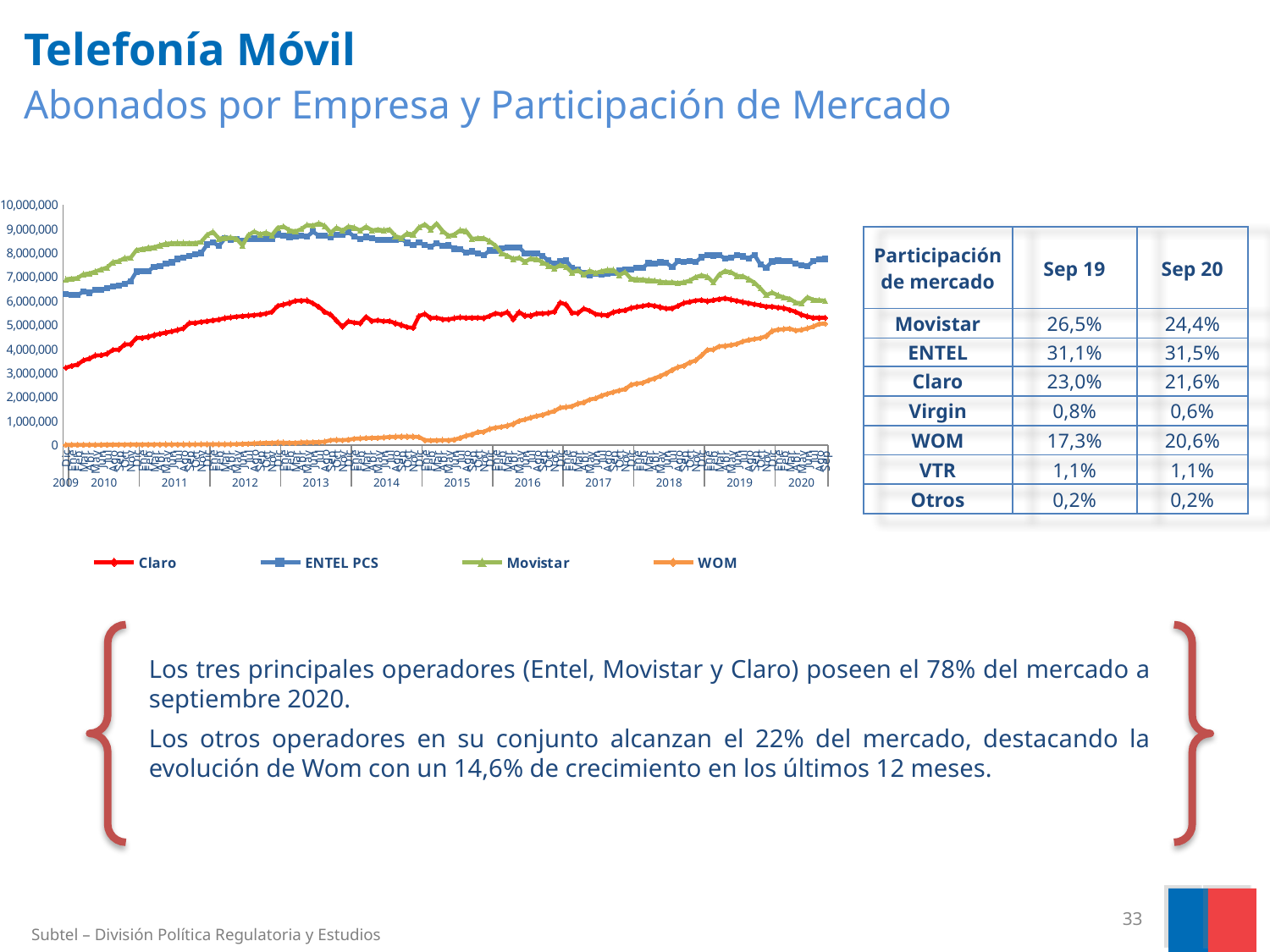
Is the value for Movistar in 2020 greater or less than 7,000,000? less What kind of chart is shown on the slide? line chart Is the value for WOM in 2020 greater or less than 4,000,000? greater Which series has the highest value at the end of the chart in 2020? ENTEL PCS Does the WOM series rise or fall from 2015 to 2020? rise Is the value for WOM in 2013 greater or less than 1,000,000? less How many series does the chart legend list? 4 Which series has the lowest value in 2009? WOM In 2020, which series is larger, ENTEL PCS or Movistar? ENTEL PCS Which colour is used for the Claro series in the chart? red